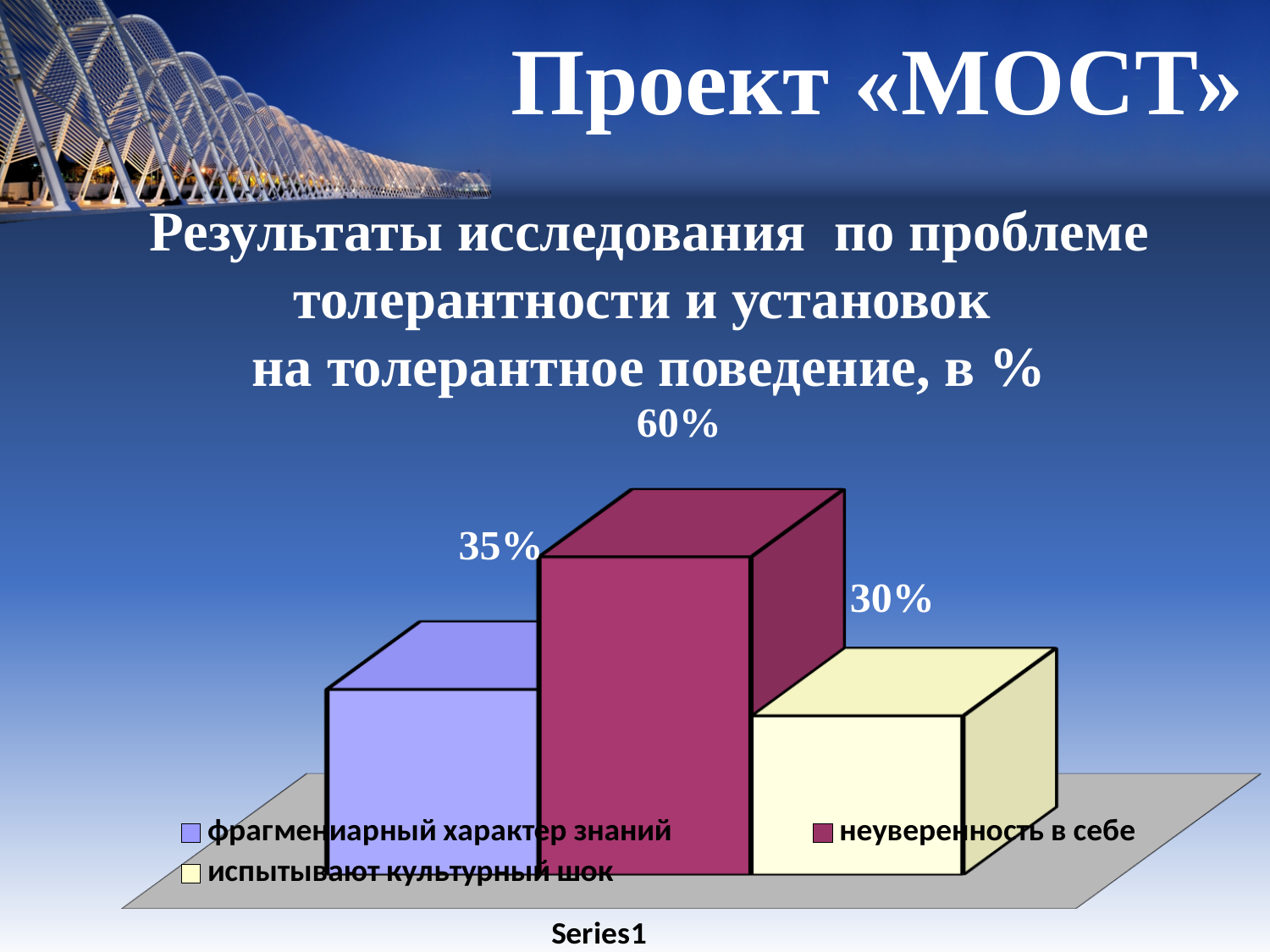
Which is larger: the value for «фрагмениарный характер знаний» or the value for «неуверенность в себе»? неуверенность в себе What value is shown for «испытывают культурный шок»? 30% What colour is the bar for «неуверенность в себе»? magenta How many bars are plotted in the chart? 3 What value is shown for «фрагмениарный характер знаний»? 35% What value is shown for «неуверенность в себе»? 60% Which category has the highest value? неуверенность в себе How many entries does the legend list? 3 What is the difference between the values for «фрагмениарный характер знаний» and «испытывают культурный шок»? 5% What is the difference between the values for «неуверенность в себе» and «испытывают культурный шок»? 30% Which category has the lowest value? испытывают культурный шок What kind of chart is shown on the slide? bar chart